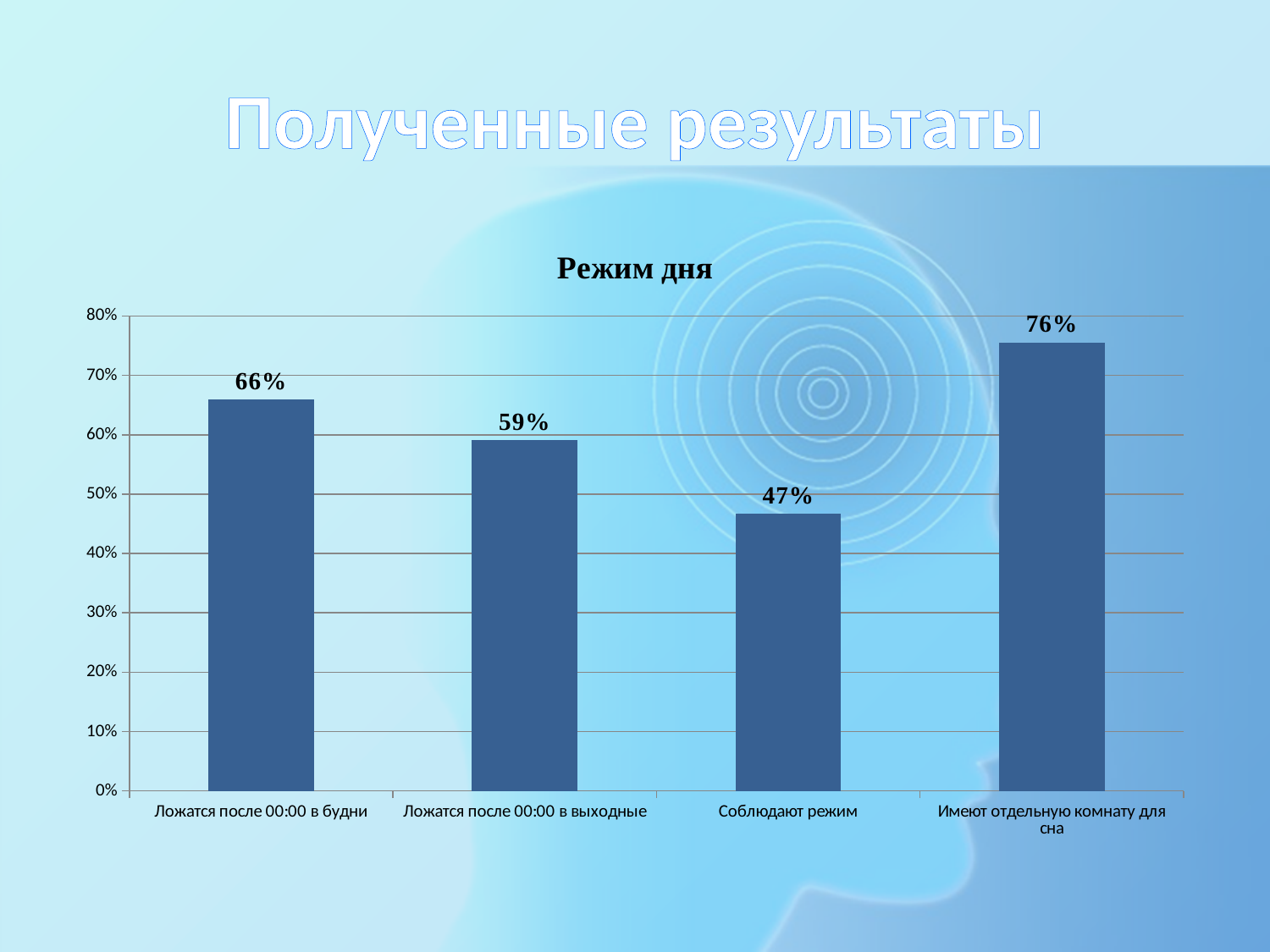
What is the value for "Ложатся после 00:00 в будни"? 66% Is the value for "Соблюдают режим" greater or less than 50%? less What is the value for "Ложатся после 00:00 в выходные"? 59% Which is larger: the value for "Ложатся после 00:00 в будни" or "Ложатся после 00:00 в выходные"? Ложатся после 00:00 в будни How many categories are shown in the chart? 4 Which category has the lowest value? Соблюдают режим What kind of chart is shown on the slide? bar chart What is the title of the chart? Режим дня What is the value for "Соблюдают режим"? 47% What is the difference between the values for "Имеют отдельную комнату для сна" and "Соблюдают режим"? 29% Which category has the highest value? Имеют отдельную комнату для сна What is the value for "Имеют отдельную комнату для сна"? 76%